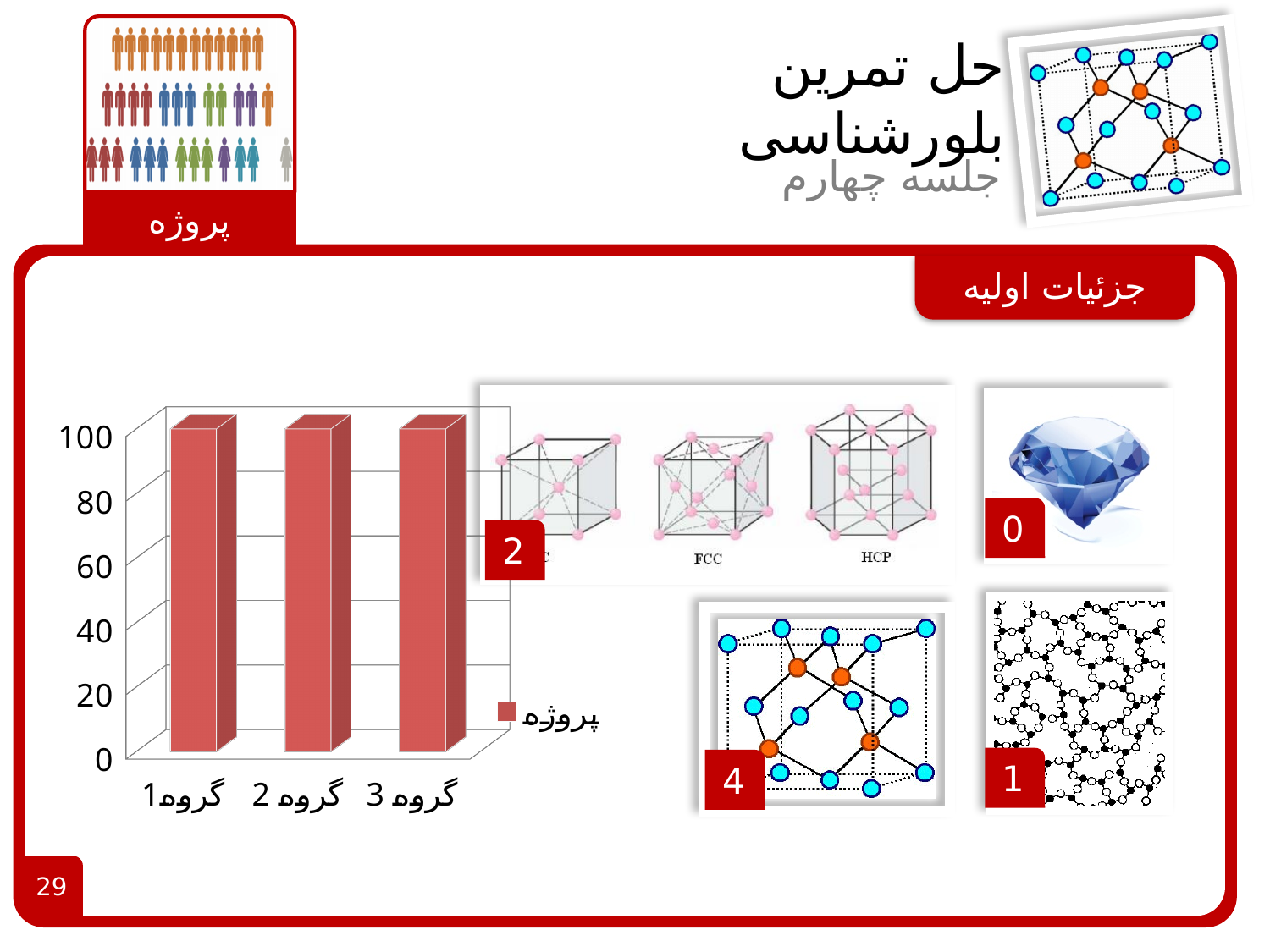
Is the value for گروه 2 greater or less than 60? greater What are the three category labels on the x axis of the bar chart? گروه1, گروه 2, گروه 3 How many categories are shown on the x axis of the bar chart? 3 How many series does the legend of the bar chart list? 1 What is the name of the series shown in the legend of the bar chart? پروژه Do the bar values rise, fall, or stay the same from گروه1 to گروه 3? stay the same What kind of chart is shown on the slide? bar chart Is the value for گروه1 greater or less than 80? greater Is the value for گروه 3 greater or less than 80? greater What is the highest value shown on the vertical axis of the bar chart? 100